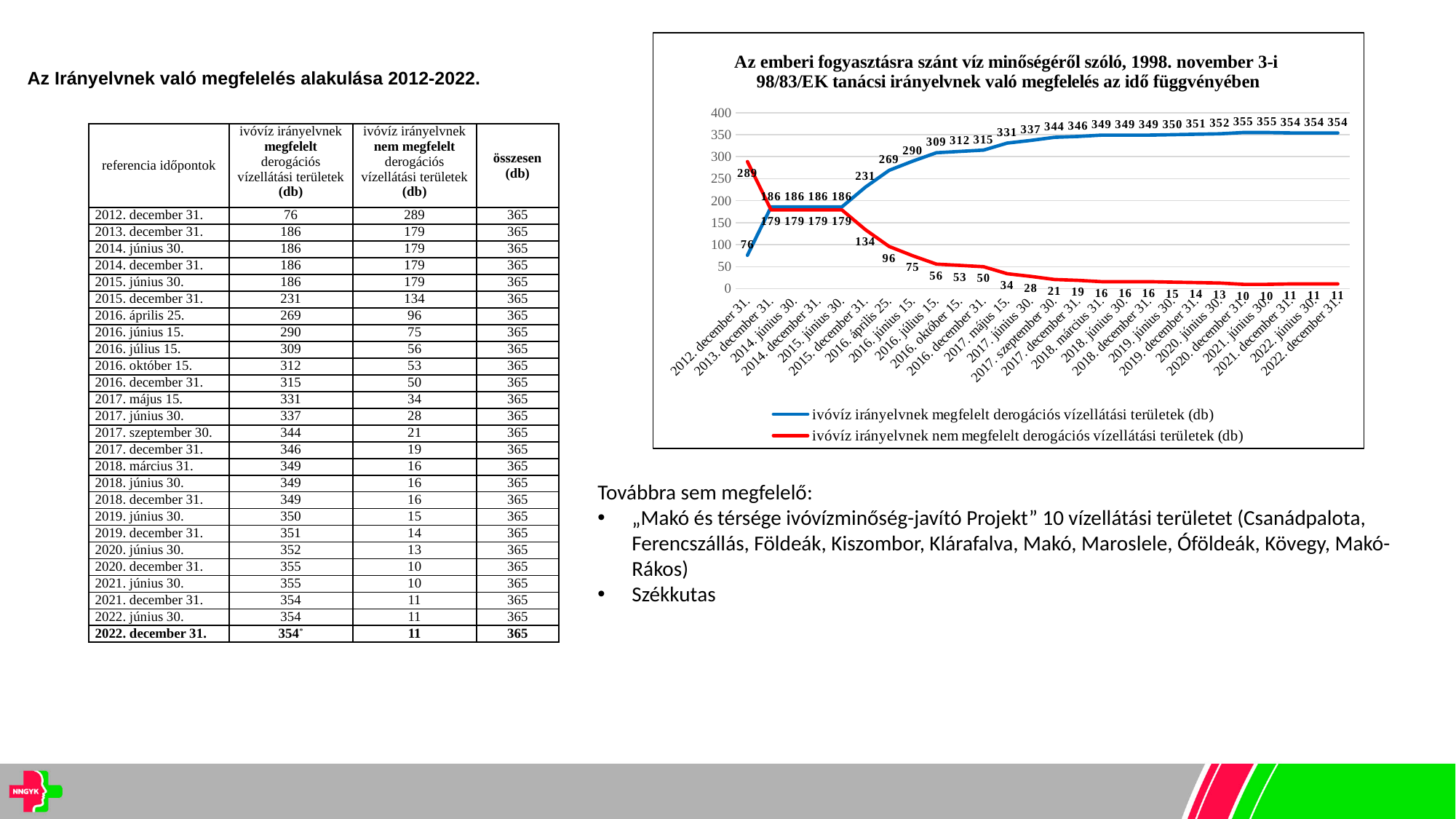
How many series does the chart's legend list? 2 Does the 'megfelelt' (blue) series generally rise or fall over time? rise At 2013. december 31., which series has the larger value? ivóvíz irányelvnek megfelelt derogációs vízellátási területek (db) What is the value of the 'ivóvíz irányelvnek nem megfelelt derogációs vízellátási területek (db)' series at 2016. április 25.? 96 What is the lowest value shown for the 'nem megfelelt' (red) series? 10 What is the value of the 'ivóvíz irányelvnek megfelelt derogációs vízellátási területek (db)' series at 2012. december 31.? 76 How many reference time points are plotted along the x axis? 26 What kind of chart is shown on the slide? line chart What is the highest value shown for the 'megfelelt' (blue) series? 355 At 2012. december 31., what is the difference between the 'nem megfelelt' value and the 'megfelelt' value? 213 What is the sum of the two series' values at 2017. május 15.? 365 What is the value of the 'megfelelt' (blue) series at 2022. december 31.? 354